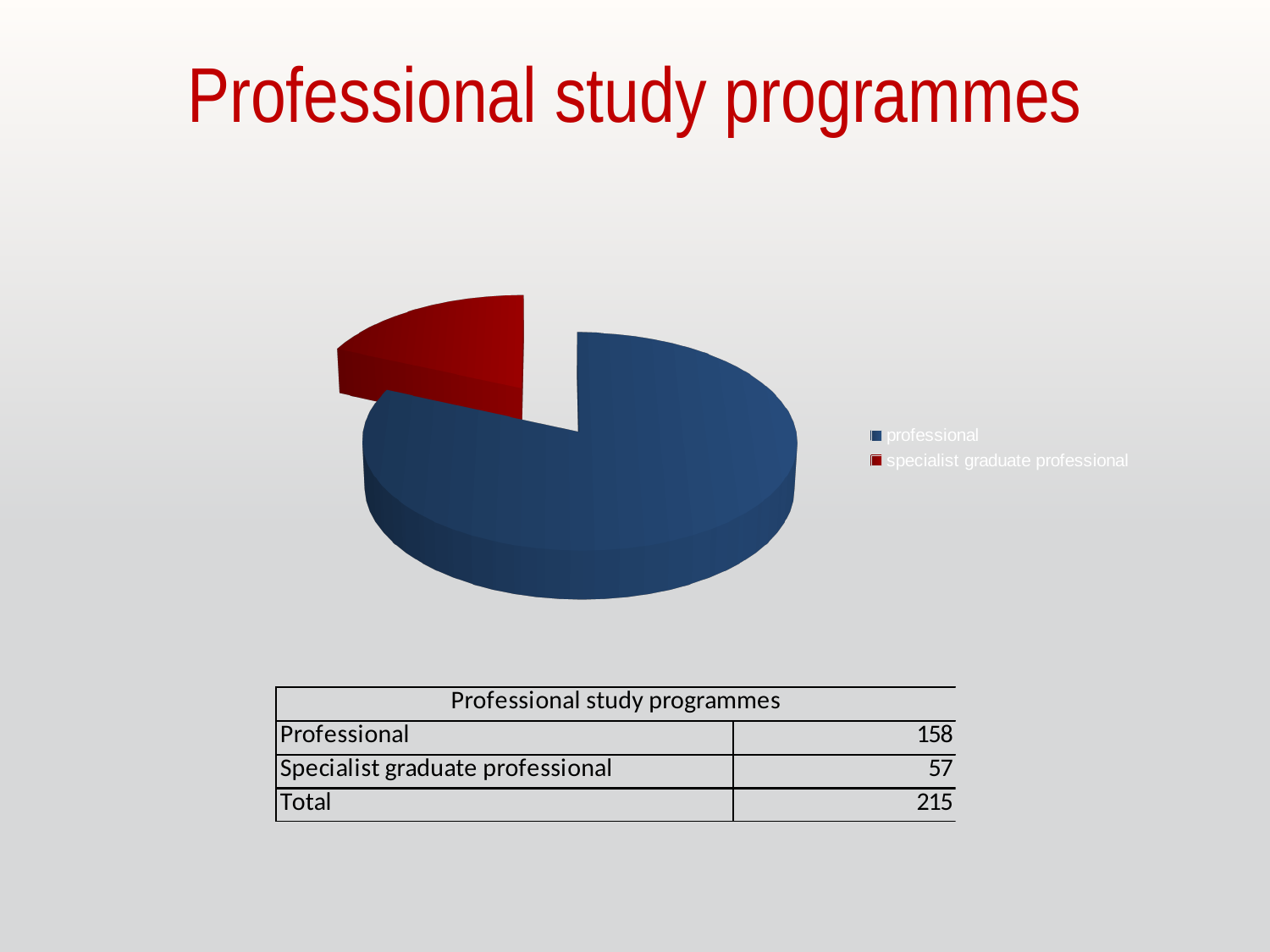
What is the total of all professional study programmes shown? 215 Which is larger, the value for Professional or the value for Specialist graduate professional? Professional What colour is the slice for professional in the pie chart? blue Which category has the largest slice of the pie? professional What kind of chart is shown on the slide? pie chart Which category has the smallest slice of the pie? specialist graduate professional What is the difference between the values for Professional and Specialist graduate professional? 101 How many slices does the pie chart have? 2 What is the value for Specialist graduate professional? 57 What is the value for Professional? 158 How many entries does the legend of the pie chart list? 2 What is the title of the slide containing the pie chart? Professional study programmes